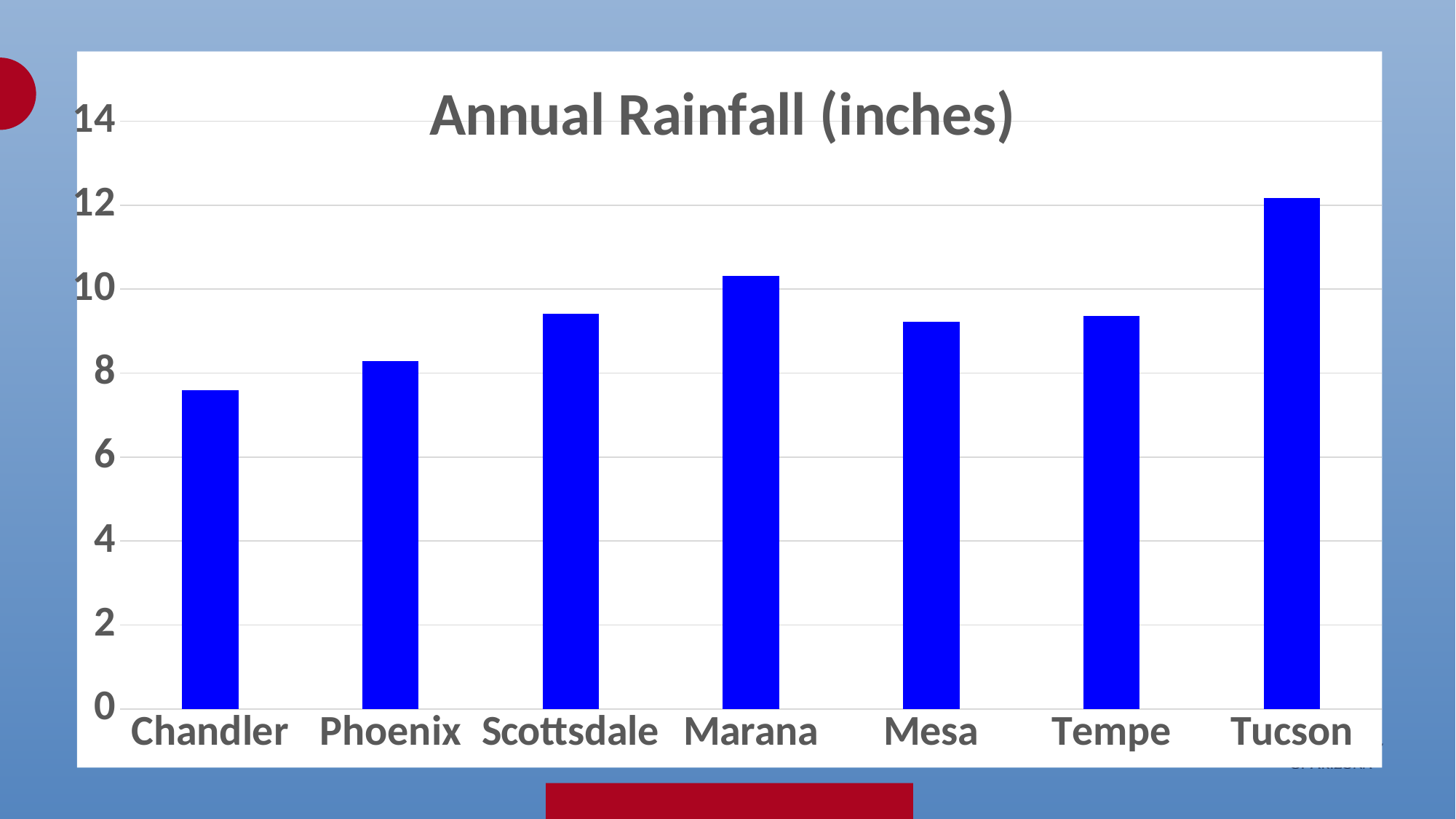
What colour are the bars on the chart? blue Is the value for Tucson greater or less than 12? greater Is the value for Phoenix greater or less than 8? greater How many cities are shown on the chart? 7 Which city has the highest annual rainfall? Tucson What is the title of the chart? Annual Rainfall (inches) Is the value for Mesa greater or less than 10? less Which city has the lowest annual rainfall? Chandler What kind of chart is shown on the slide? bar chart Which has the higher annual rainfall, Marana or Phoenix? Marana